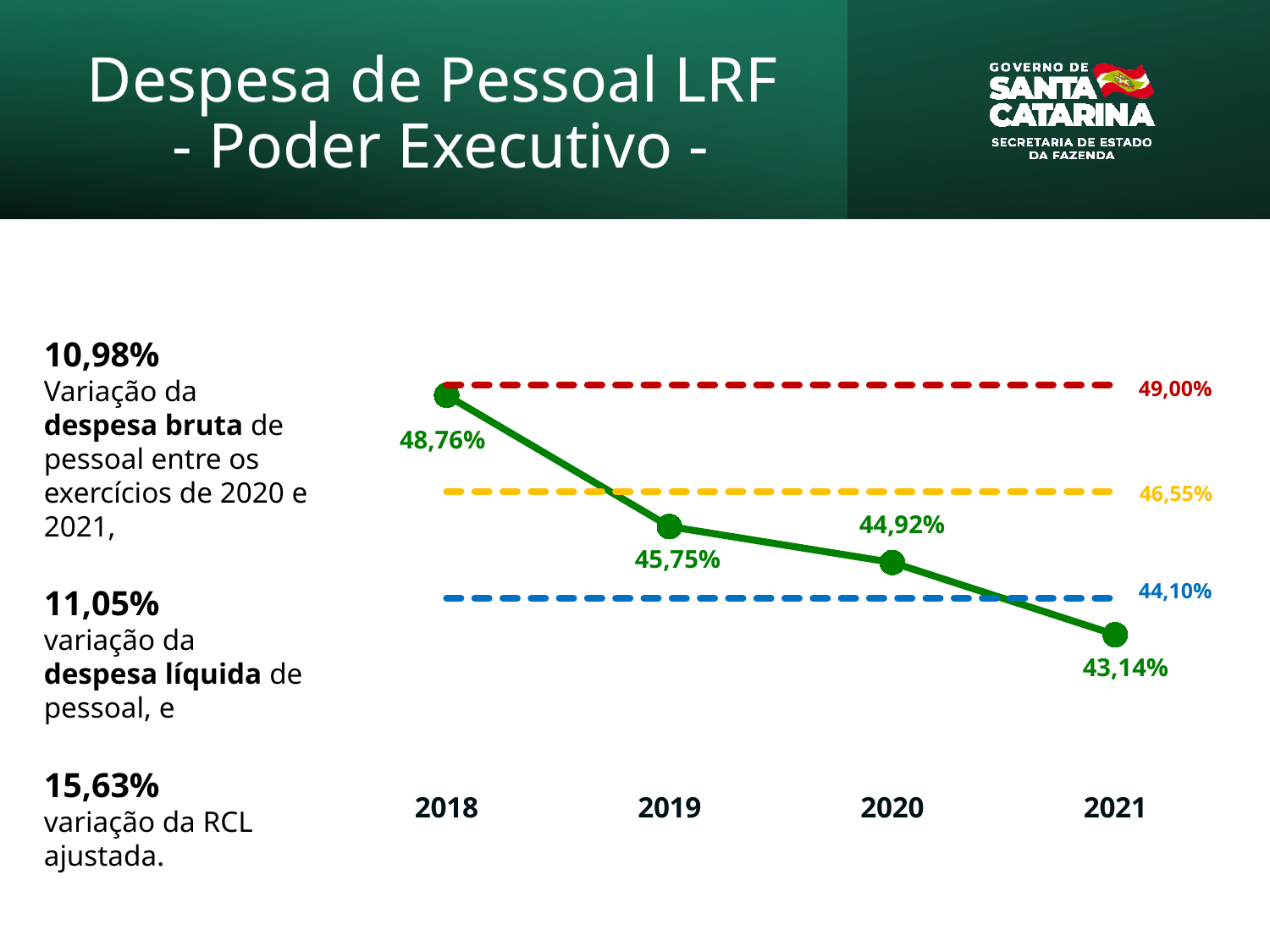
What is the difference between the 2019 value and the 2020 value? 0,83% Which year has the highest value on the green line? 2018 What kind of chart is shown on the slide? Line chart Which is larger, the value for 2019 or the value for 2020? 2019 What is the value plotted for 2019? 45,75% What is the difference between the 2018 value and the 2021 value? 5,62% What is the value plotted for 2021? 43,14% What is the value plotted for 2020? 44,92% How many years are plotted on the x axis? 4 Do the plotted values rise or fall from 2018 to 2021? Fall Which year has the lowest value on the green line? 2021 What is the value plotted for 2018? 48,76%